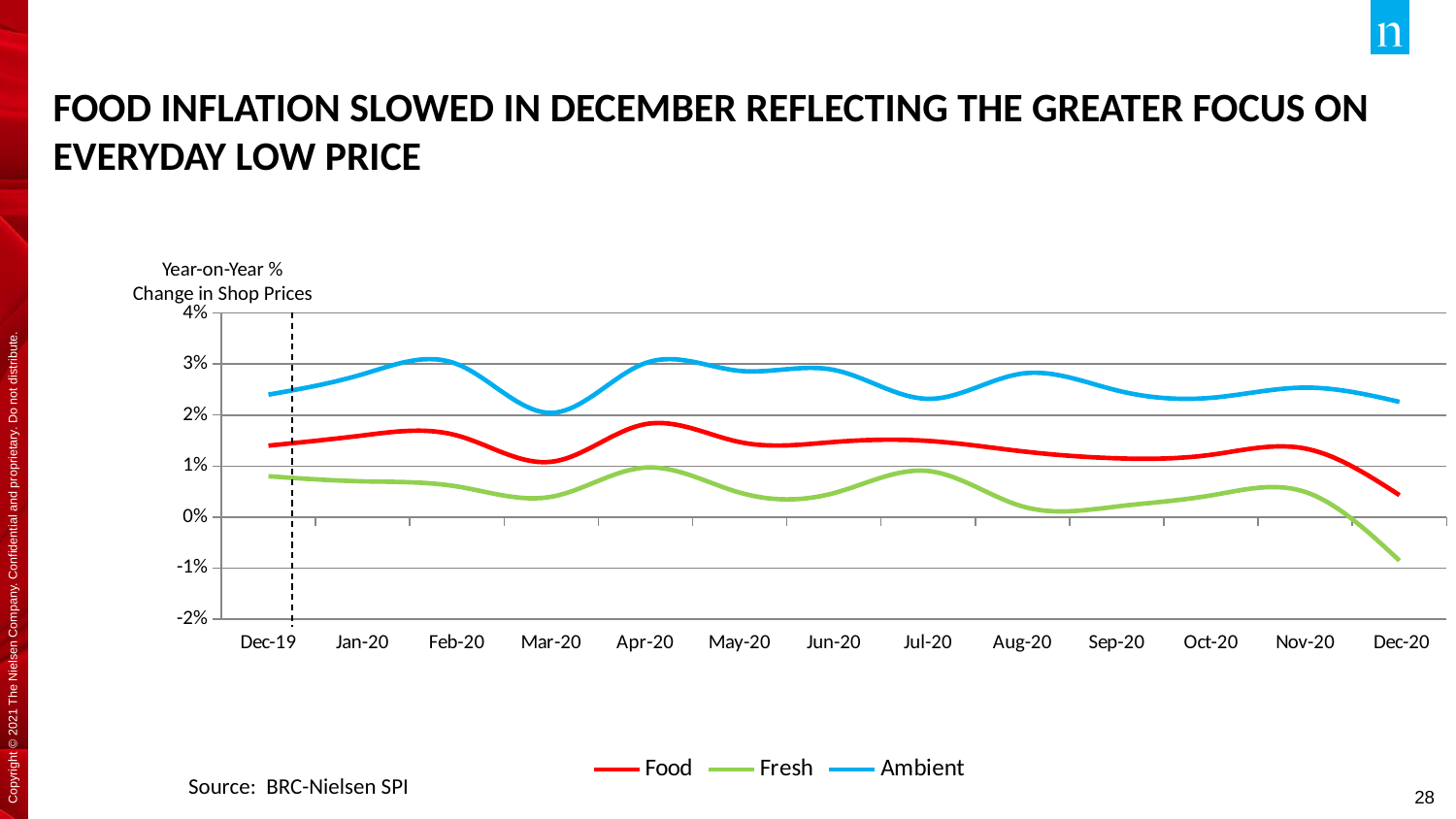
How many series does the legend list? 3 Is the value for Food in Apr-20 greater or less than 2%? less Which is larger in Dec-20, the Ambient value or the Food value? Ambient Does the Fresh series rise or fall between Nov-20 and Dec-20? fall How many months are shown along the x axis? 13 In which month does the Fresh series reach its lowest value? Dec-20 Which series has the highest values across the whole period? Ambient What colour is the line for the Ambient series? blue Is the value for Food in Dec-20 greater or less than 1%? less What kind of chart is shown on the slide? line chart Is the value for Ambient in Dec-19 greater or less than 2%? greater